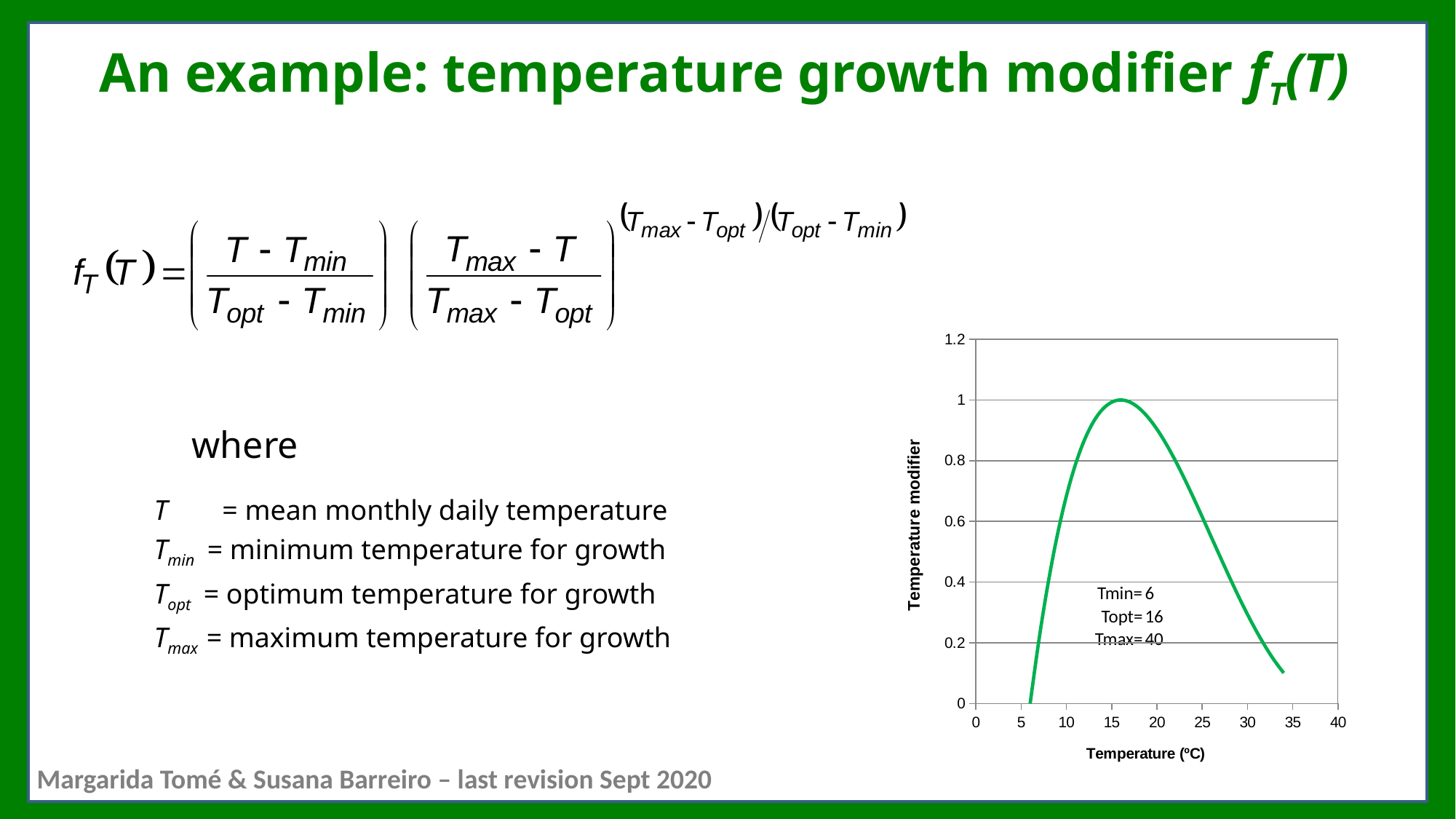
Is the temperature modifier at 20 ºC greater or less than 0.6? greater How many lines are plotted on the chart? 1 What kind of chart is shown on the slide? line chart Does the temperature modifier rise or fall as temperature increases from 20 ºC to 35 ºC? fall Is the temperature modifier at 30 ºC greater or less than 0.6? less What is the maximum value of the temperature modifier reached by the curve? 1 Is the temperature modifier at 10 ºC greater or less than 0.4? greater What value of Tmax is annotated on the chart? 40 What is the label of the x axis of the chart? Temperature (ºC) What is the label of the y axis of the chart? Temperature modifier At what temperature does the temperature modifier reach its highest value? 16 What value of Tmin is annotated on the chart? 6